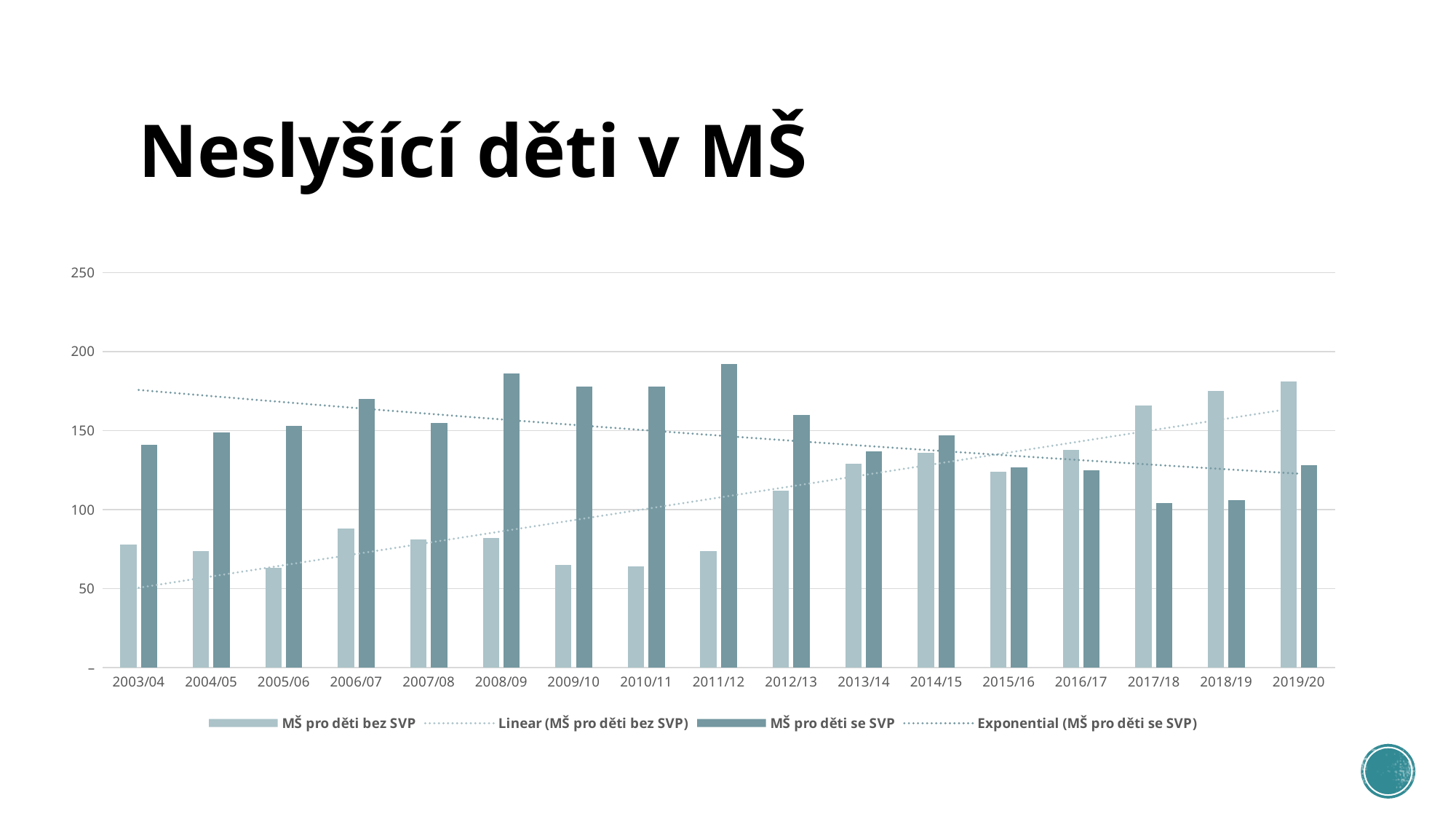
Is the value for MŠ pro děti se SVP in 2017/18 greater or less than 150? less How many school years are shown on the x axis? 17 In 2019/20, which is larger: MŠ pro děti bez SVP or MŠ pro děti se SVP? MŠ pro děti bez SVP Is the value for MŠ pro děti se SVP in 2011/12 greater or less than 150? greater What kind of chart is shown on the slide? bar chart Is the value for MŠ pro děti bez SVP in 2019/20 greater or less than 150? greater What is the title of the slide? Neslyšící děti v MŠ In 2003/04, which is larger: MŠ pro děti bez SVP or MŠ pro děti se SVP? MŠ pro děti se SVP According to the trendline, do the values for MŠ pro děti se SVP rise or fall over the years? fall In which school year is the value for MŠ pro děti se SVP highest? 2011/12 How many entries does the legend list? 4